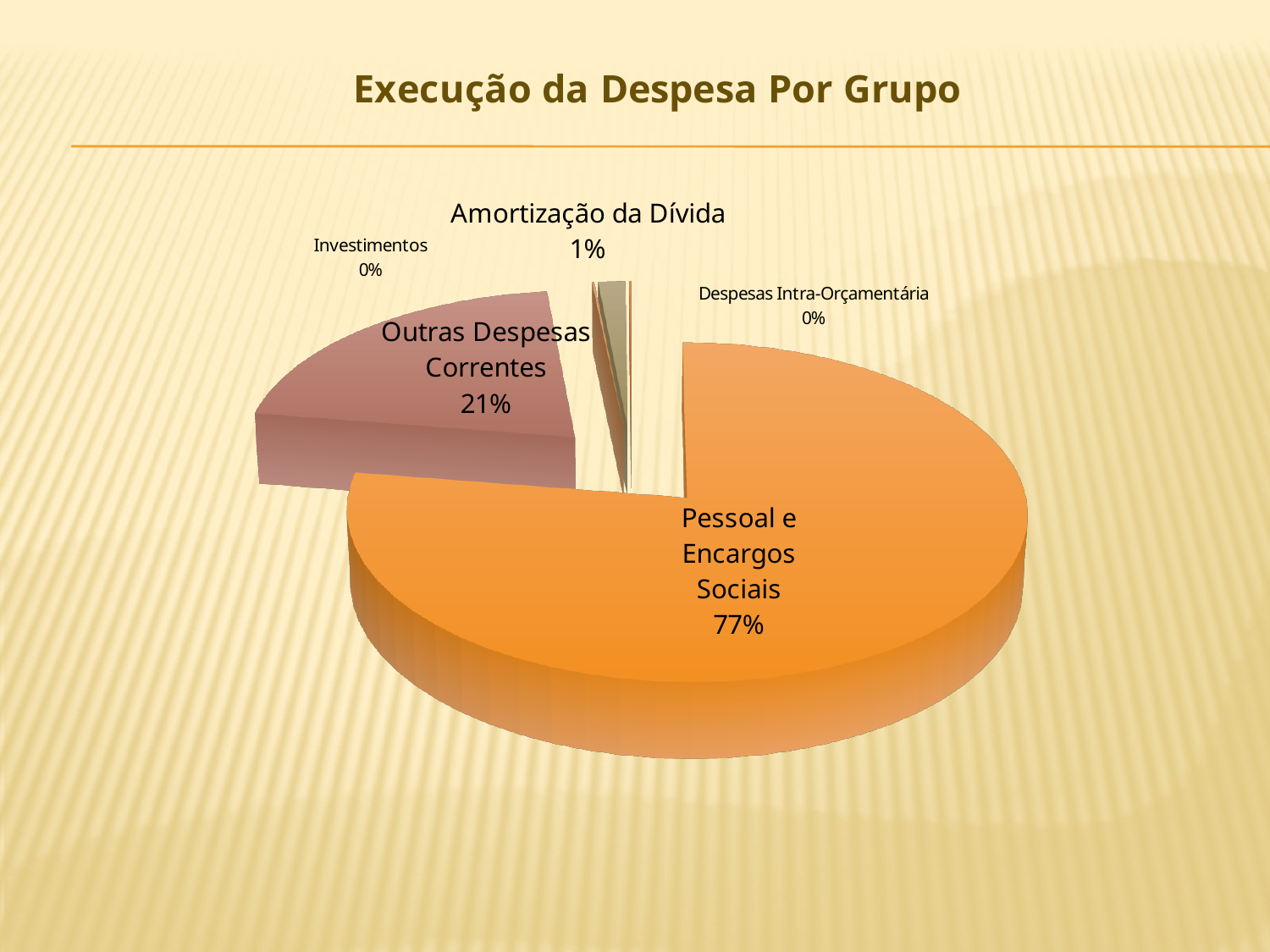
Which category has the largest slice of the pie? Pessoal e Encargos Sociais How many categories are labelled with 0%? 2 What is the title of the chart? Execução da Despesa Por Grupo What is the difference in percentage points between Pessoal e Encargos Sociais and Outras Despesas Correntes? 56 percentage points What kind of chart is shown on the slide? pie chart What is the value shown for Investimentos? 0% How many categories are shown in the pie chart? 5 What share of the pie does Pessoal e Encargos Sociais represent? 77% What share of the pie does Outras Despesas Correntes represent? 21% What is the value shown for Amortização da Dívida? 1% What is the value shown for Despesas Intra-Orçamentária? 0% Which is larger, Outras Despesas Correntes or Amortização da Dívida? Outras Despesas Correntes